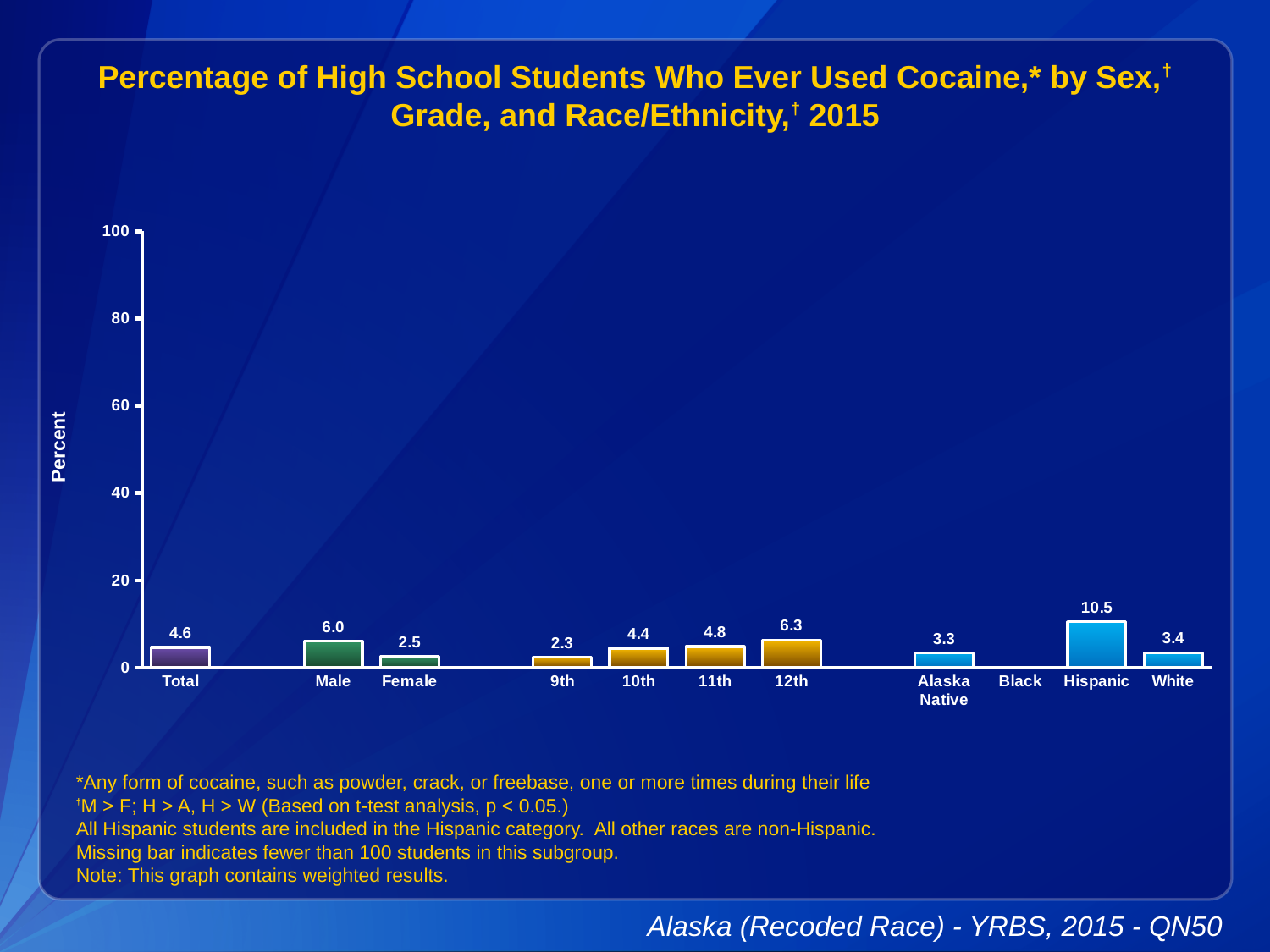
Do the values rise or fall from 9th grade to 12th grade? rise What is the value for Hispanic? 10.5 Which category has no bar shown? Black Which category has the highest value? Hispanic Which category has the lowest plotted value? 9th Is the value for Hispanic greater or less than 20? less What is the difference between the Male and Female values? 3.5 Which is larger, the value for 12th grade or the value for 10th grade? 12th What kind of chart is shown on the slide? bar chart What is the value for 9th grade? 2.3 What is the value for Total? 4.6 What is the value for Male? 6.0